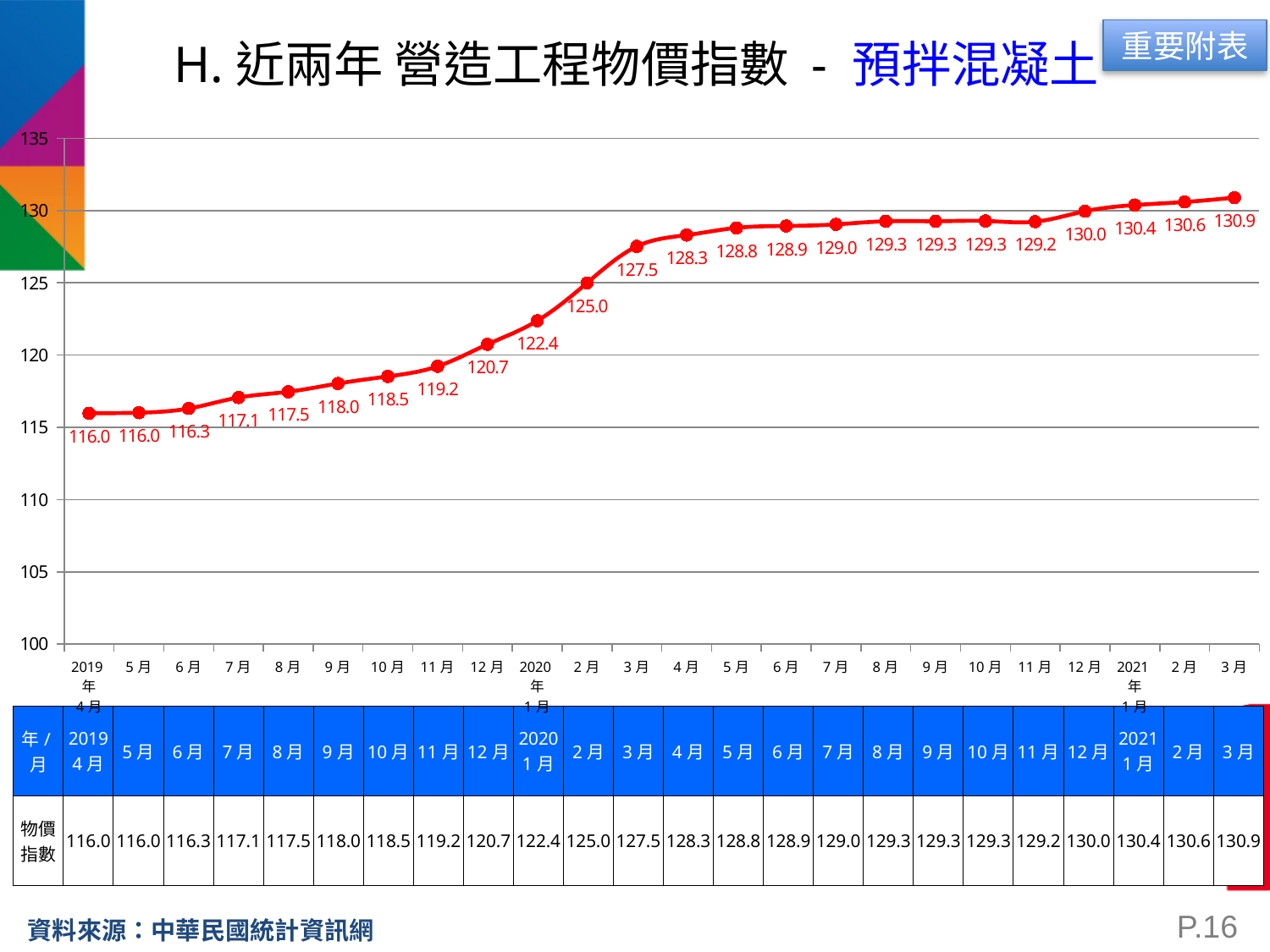
What material does the chart title say the price index is for? 預拌混凝土 What is the price index value for 2020年3月? 127.5 What is the price index value for 2019年4月? 116.0 Does the price index generally rise or fall from 2019年4月 to 2021年3月? rise What is the price index value for 2021年3月? 130.9 What is the price index value for 2020年1月? 122.4 What is the difference between the price index for 2021年3月 and 2019年4月? 14.9 What is the lowest price index value shown on the chart? 116.0 Which month has the highest price index value? 2021年3月 What type of chart is shown on the slide? line chart How many data points are plotted on the chart? 24 Which is larger, the price index for 2020年11月 or 2020年12月? 2020年12月